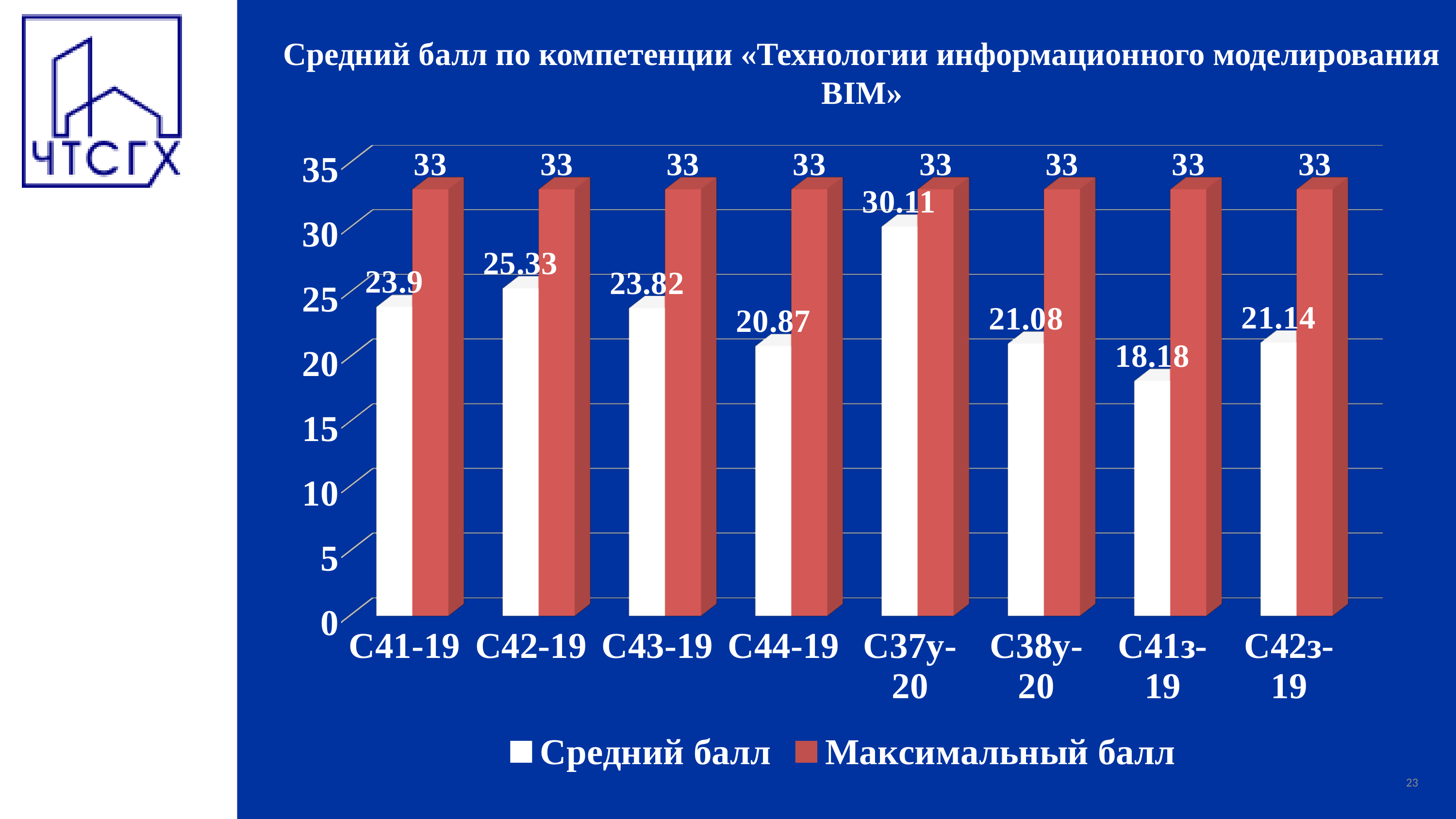
How many series does the legend list? 2 What is the difference between the Максимальный балл and the Средний балл for С41з-19? 14.82 What kind of chart is shown on the slide? bar chart How many groups are shown on the x axis? 8 Is the Средний балл for С38у-20 greater or less than 25? less What is the Максимальный балл for С44-19? 33 What colour are the Максимальный балл bars? red Which group has the lowest Средний балл? С41з-19 What is the Средний балл for С37у-20? 30.11 What is the Средний балл for С41-19? 23.9 Which group has the highest Средний балл? С37у-20 Which has a higher Средний балл, С42-19 or С43-19? С42-19